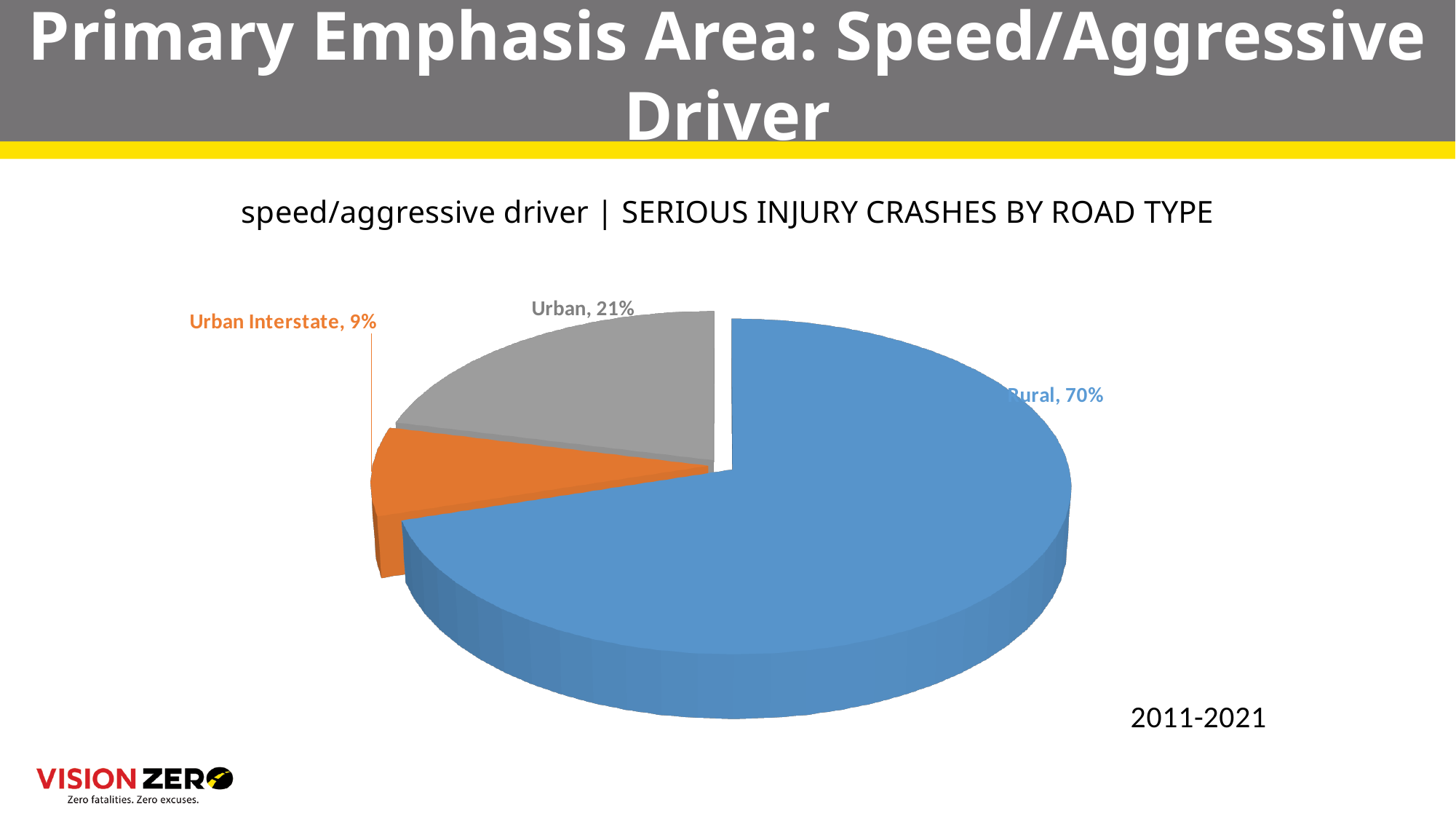
What is the title of the chart? speed/aggressive driver | SERIOUS INJURY CRASHES BY ROAD TYPE What share of serious injury crashes is attributed to Urban roads? 21% Which road type has the largest share of serious injury crashes? Rural What share of serious injury crashes is attributed to Rural roads? 70% Which has a larger share, Urban or Urban Interstate? Urban What is the difference in percentage points between the Urban and Urban Interstate shares? 12 What is the difference in percentage points between the Rural and Urban shares? 49 What kind of chart is shown on the slide? Pie chart What time period does the chart cover? 2011-2021 Which road type has the smallest share of serious injury crashes? Urban Interstate What share of serious injury crashes is attributed to Urban Interstate roads? 9% How many road type categories are shown in the pie chart? 3